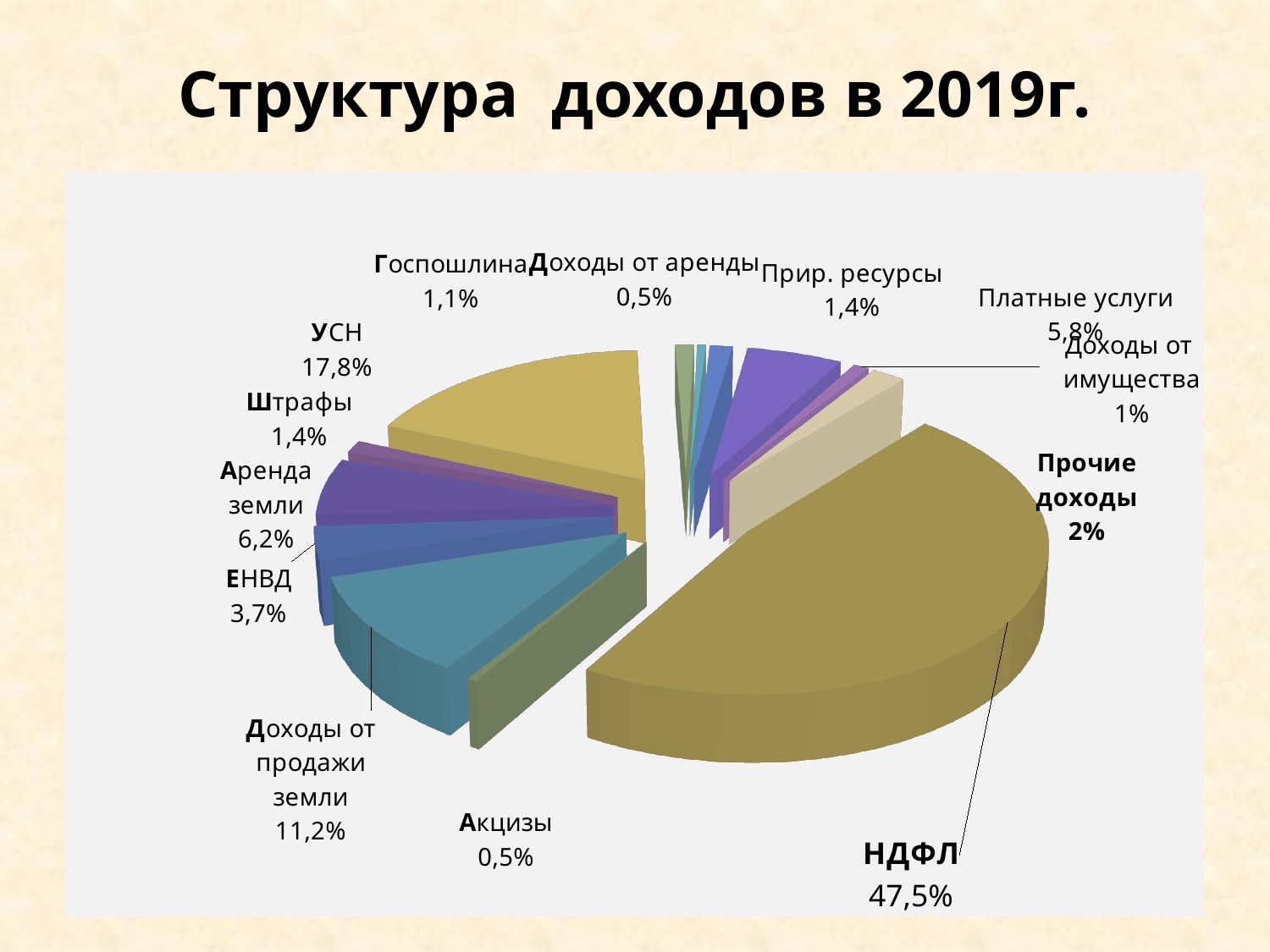
Which is larger, Аренда земли or Штрафы? Аренда земли What is the title of the chart? Структура доходов в 2019г. Which category has the largest share of the pie? НДФЛ What kind of chart is shown on the slide? Pie chart What percentage is shown for Доходы от продажи земли? 11,2% How many categories are shown in the pie chart? 13 What is the value for Платные услуги? 5,8% What percentage is shown for ЕНВД? 3,7% What is the value shown for УСН? 17,8% What is the difference between the shares of НДФЛ and УСН? 29,7% What is the value shown for Прочие доходы? 2% What share of income does НДФЛ account for? 47,5%